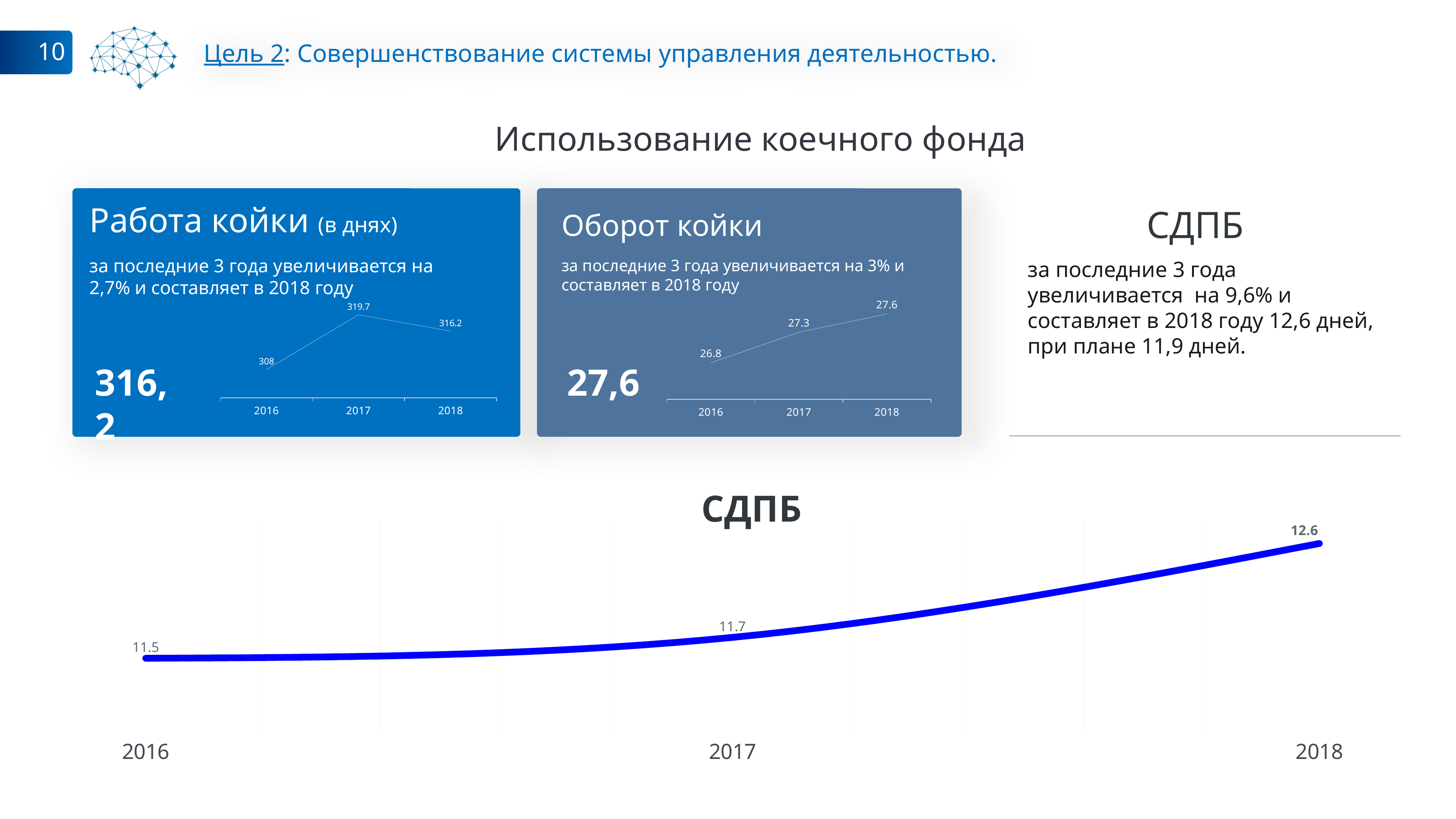
In the "СДПБ" chart at the bottom of the slide, what is the value for 2018? 12.6 How many data points are plotted in the "СДПБ" chart at the bottom of the slide? 3 In the "СДПБ" chart at the bottom of the slide, which is larger, the value for 2017 or the value for 2018? 2018 In the "Работа койки" chart, what is the value for 2017? 319.7 In the "Работа койки" chart, which year has the lowest value? 2016 In the "Работа койки" chart, what is the difference between the 2017 and 2016 values? 11.7 In the "СДПБ" chart at the bottom of the slide, what is the difference between the 2018 and 2016 values? 1.1 What colour is the line in the "СДПБ" chart at the bottom of the slide? blue What kind of chart is the "СДПБ" chart at the bottom of the slide? line chart In the "Оборот койки" chart, what is the value for 2016? 26.8 In the "Оборот койки" chart, which year has the highest value? 2018 In the "Оборот койки" chart, do the values rise or fall from 2016 to 2018? rise